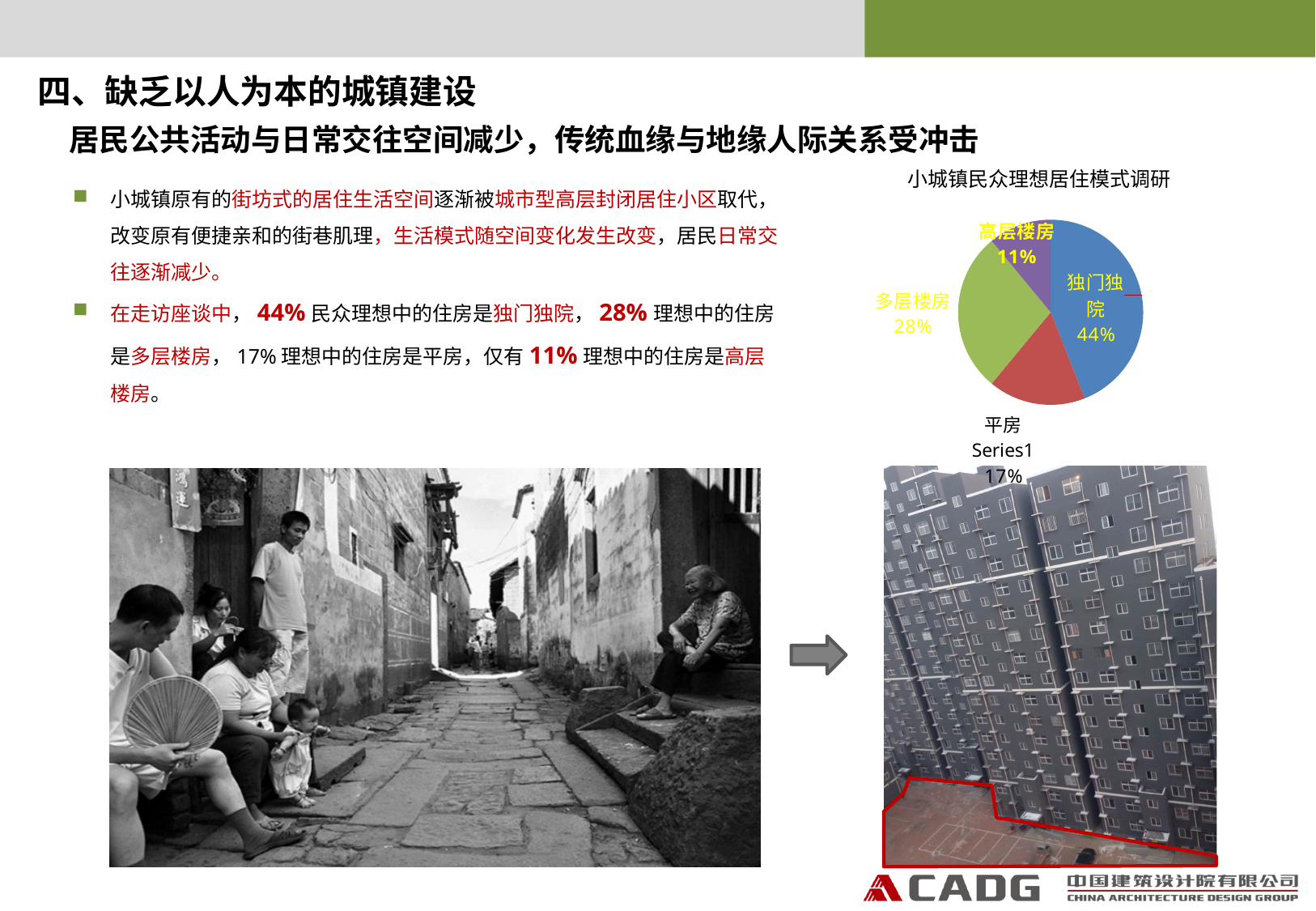
What is the title of the pie chart? 小城镇民众理想居住模式调研 What share of the pie does 平房 have? 17% What share of the pie does 多层楼房 have? 28% What kind of chart is shown on the slide? pie chart How many slices does the pie chart have? 4 Which is larger, the share for 平房 or the share for 高层楼房? 平房 What share of the pie does 独门独院 have? 44% What is the difference in percentage points between 独门独院 and 多层楼房? 16 Which category has the smallest slice of the pie? 高层楼房 What colour is the 独门独院 slice of the pie? blue Which category has the largest slice of the pie? 独门独院 What share of the pie does 高层楼房 have? 11%